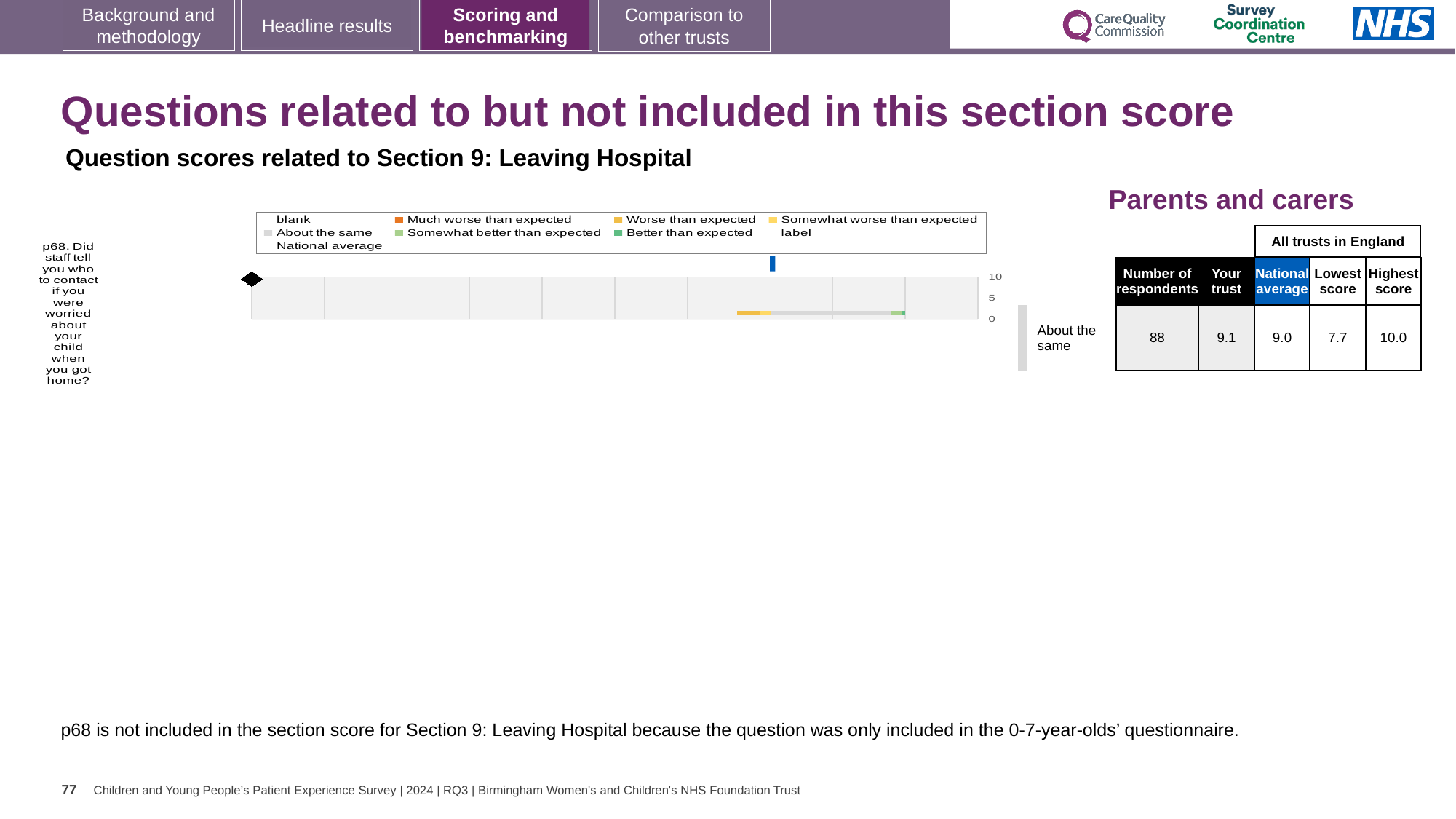
Is the trust's score for p68 greater or less than 5 on the chart's axis? greater Is the trust's score for p68 higher or lower than the national average? higher How many respondents answered p68? 88 What is the highest tick value shown on the chart's score axis? 10 Which benchmark category is the trust's result for p68 placed in? About the same What is the trust's score for p68? 9.1 What is the national average score for p68? 9.0 What kind of chart is shown on the slide? bar chart What is the difference between the trust's score and the national average for p68? 0.1 Which survey question is plotted in the chart? p68. Did staff tell you who to contact if you were worried about your child when you got home? What is the highest score among all trusts in England for p68? 10.0 What is the lowest score among all trusts in England for p68? 7.7